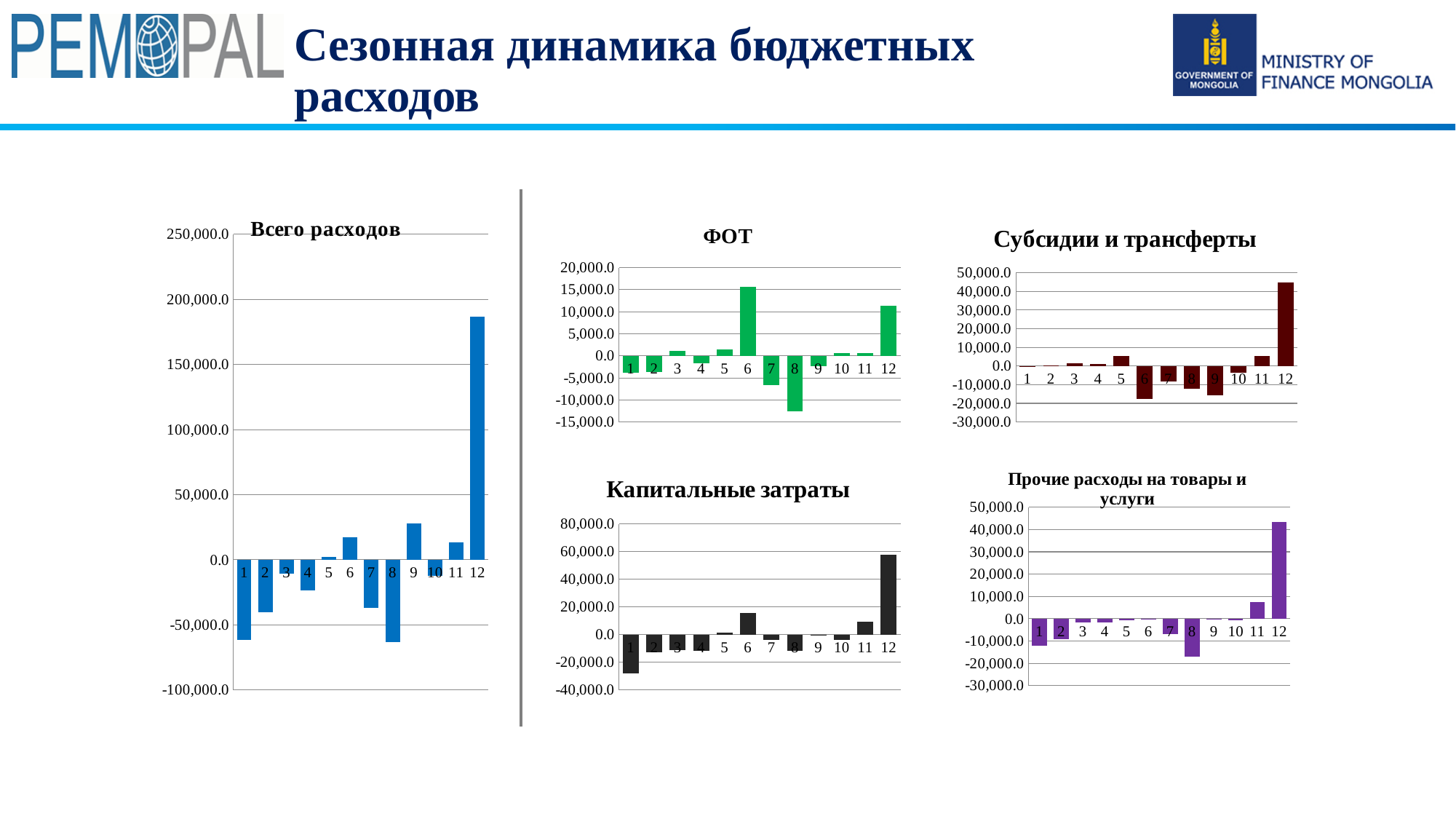
In the 'ФОТ' chart, which category has the lowest value? 8 In the 'Всего расходов' chart, which category has the highest value? 12 In the 'ФОТ' chart, is the value for category 8 greater or less than -10,000.0? less In the 'Всего расходов' chart, how many categories are plotted on the x axis? 12 What kind of chart is the 'Всего расходов' chart? bar chart In the 'Всего расходов' chart, is the value for category 12 greater or less than 150,000.0? greater How many charts are shown on the slide? 5 In the 'ФОТ' chart, which category has the highest value? 6 In the 'Прочие расходы на товары и услуги' chart, which category has the lowest value? 8 In the 'Капитальные затраты' chart, is the value for category 12 greater or less than 40,000.0? greater In the 'Капитальные затраты' chart, which category has the lowest value? 1